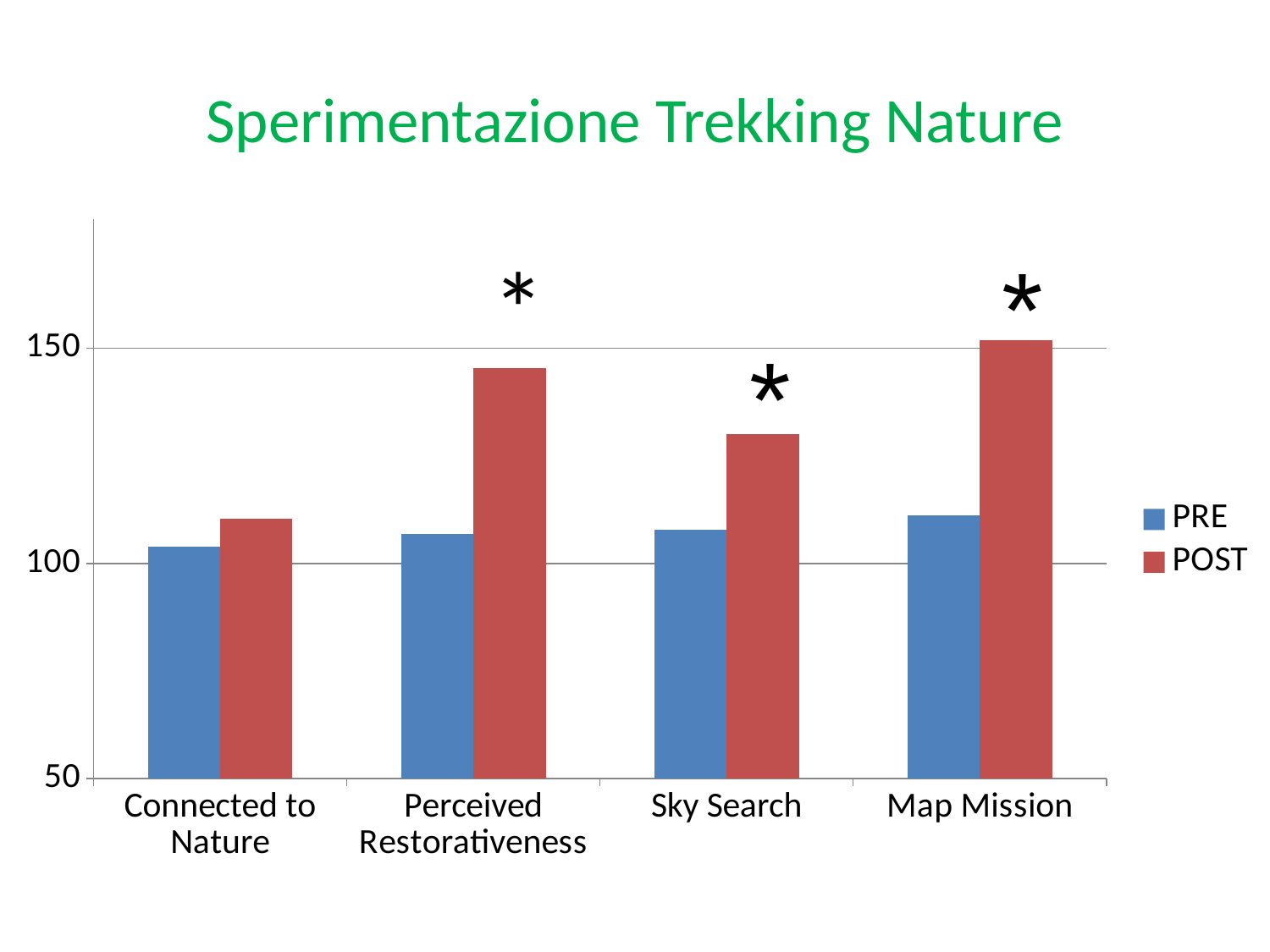
What is the title of the chart? Sperimentazione Trekking Nature Is the POST value for Perceived Restorativeness greater or less than 150? less Is the PRE value for Map Mission greater or less than 100? greater How many series does the legend list? 2 How many categories are shown on the x axis? 4 Which is larger, the POST value for Perceived Restorativeness or the POST value for Sky Search? Perceived Restorativeness Is the POST value for Sky Search greater or less than 150? less Which category has the highest POST value? Map Mission Which category has the lowest POST value? Connected to Nature For Sky Search, which is larger, the PRE value or the POST value? POST What are the two series names listed in the legend? PRE and POST What kind of chart is shown on the slide? bar chart